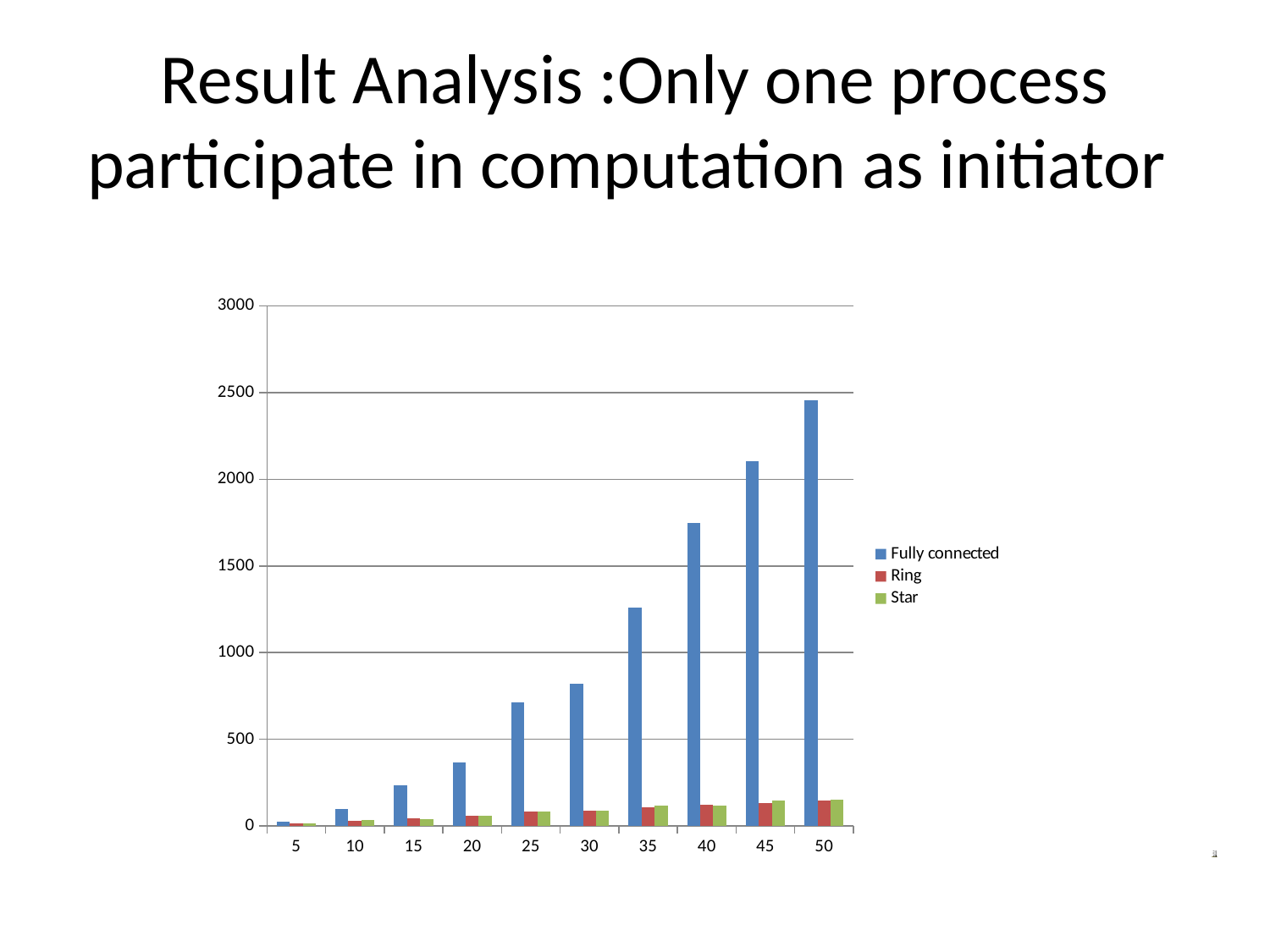
Do the Fully connected values rise or fall as the x-axis value increases from 5 to 50? rise At which x-axis category is the Fully connected series highest? 50 What kind of chart is shown on the slide? bar chart How many categories are shown along the x axis? 10 Is the value for Fully connected at 40 greater or less than 1500? greater How many series does the legend list? 3 At which x-axis category is the Fully connected series lowest? 5 At 50, which is larger: Fully connected or Ring? Fully connected Is the value for Fully connected at 50 greater or less than 2000? greater Is the value for Fully connected at 30 greater or less than 1000? less Which series is listed first in the legend? Fully connected